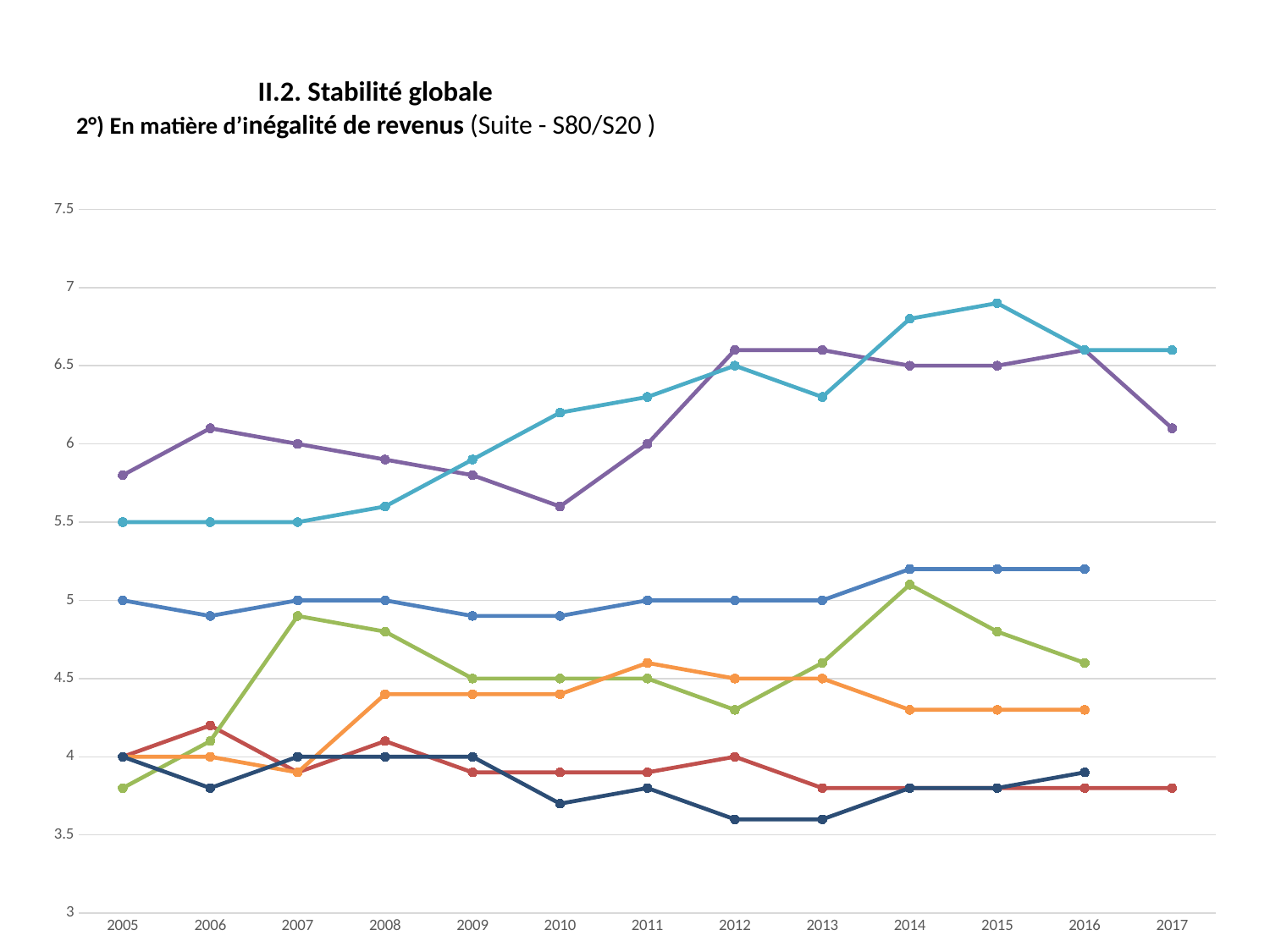
What is the value of the purple line in 2015? 6.5 What is the value of the medium blue line in 2013? 5 In 2017, which line is higher: the light blue (cyan) line or the purple line? the light blue (cyan) line How many years are shown along the x axis of the chart? 13 Which line has the lowest value in 2012? the dark navy line Is the value of the light blue (cyan) line in 2015 greater or less than 6.5? greater What kind of chart is shown on the slide? line chart Is the value of the purple line in 2010 greater or less than 6? less What is the value of the light blue (cyan) line in 2005? 5.5 What is the value of the green line in 2010? 4.5 Does the light blue (cyan) line generally rise or fall from 2005 to 2017? rise Is the value of the dark navy line in 2012 greater or less than 4? less